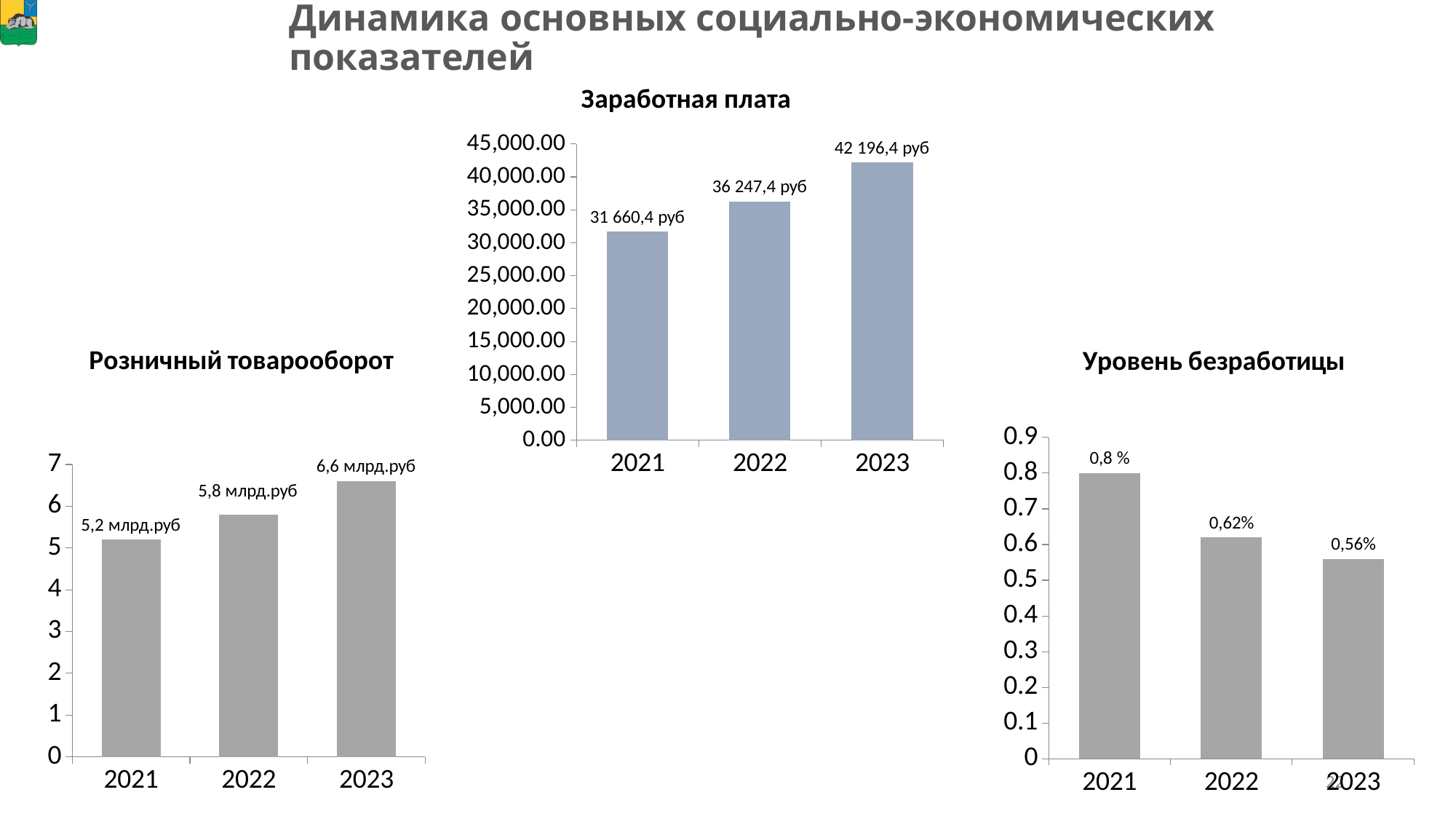
In the 'Розничный товарооборот' chart, what is the value for 2022? 5,8 млрд.руб In the 'Розничный товарооборот' chart, which year has the highest value? 2023 In the 'Розничный товарооборот' chart, is the value for 2021 greater or less than 5? greater In the 'Уровень безработицы' chart, do the values rise or fall from 2021 to 2023? fall What kind of chart is the 'Уровень безработицы' chart? bar chart In the 'Уровень безработицы' chart, which year has the highest value? 2021 In the 'Уровень безработицы' chart, what is the value for 2023? 0,56% In the 'Заработная плата' chart, which year has the lowest value? 2021 In the 'Заработная плата' chart, what is the value for 2021? 31 660,4 руб In the 'Заработная плата' chart, what is the value for 2023? 42 196,4 руб In the 'Розничный товарооборот' chart, how many years are shown? 3 In the 'Заработная плата' chart, do the values rise or fall from 2021 to 2023? rise